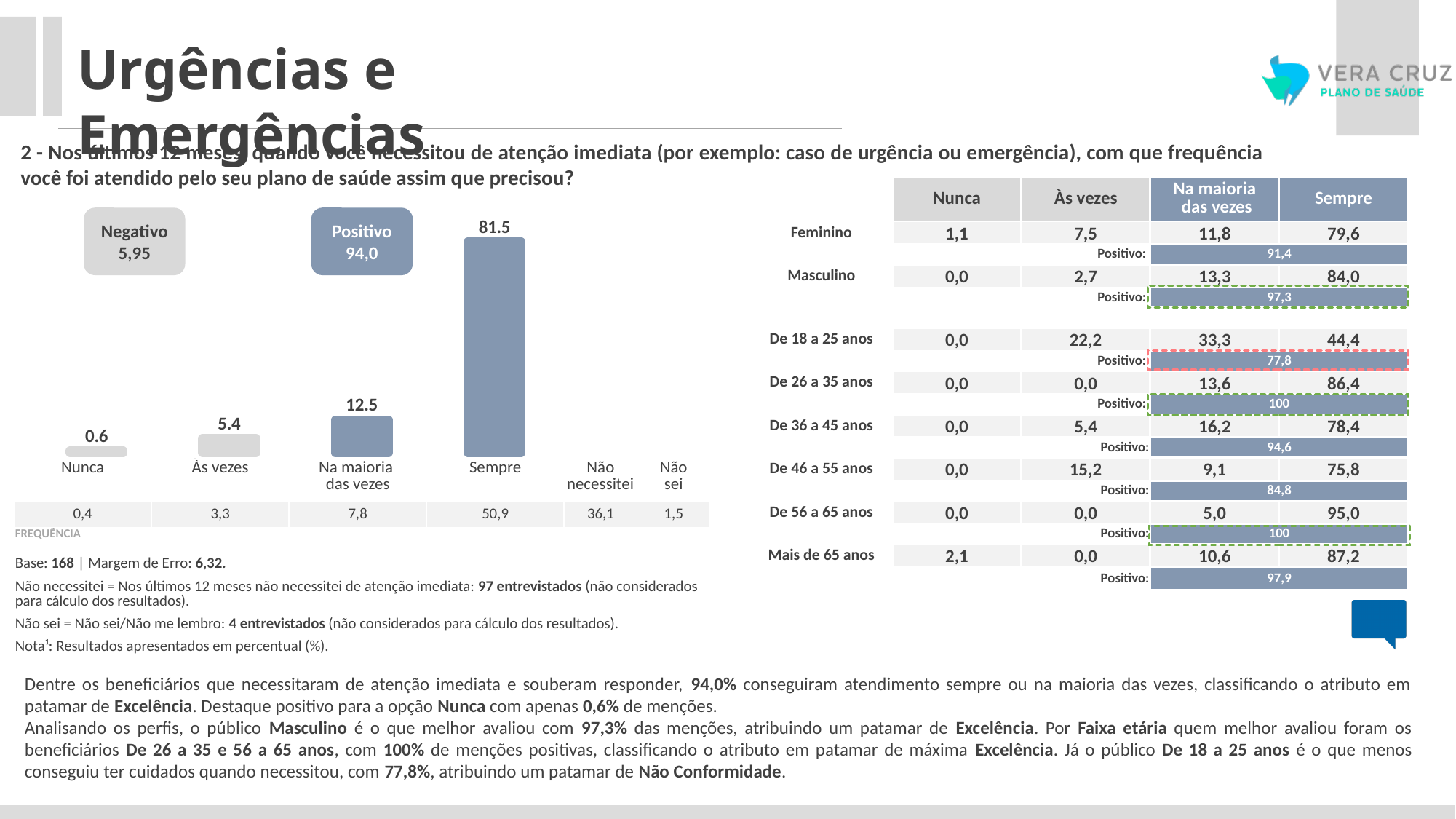
What kind of chart is shown on the left of the slide? bar chart What is the difference between the values for Às vezes and Nunca in the bar chart? 4.8 What is the value for Na maioria das vezes in the bar chart? 12.5 What is the difference between the values for Sempre and Na maioria das vezes in the bar chart? 69.0 What is the value for Às vezes in the bar chart? 5.4 Which category has the lowest bar in the bar chart? Nunca In the bar chart, which is larger: Às vezes or Na maioria das vezes? Na maioria das vezes What is the value for Nunca in the bar chart? 0.6 What is the value for Sempre in the bar chart? 81.5 Do the bar values rise or fall from Nunca to Sempre along the x axis? rise What value is shown in the Positivo box above the bar chart? 94,0 Which category has the highest bar in the bar chart? Sempre